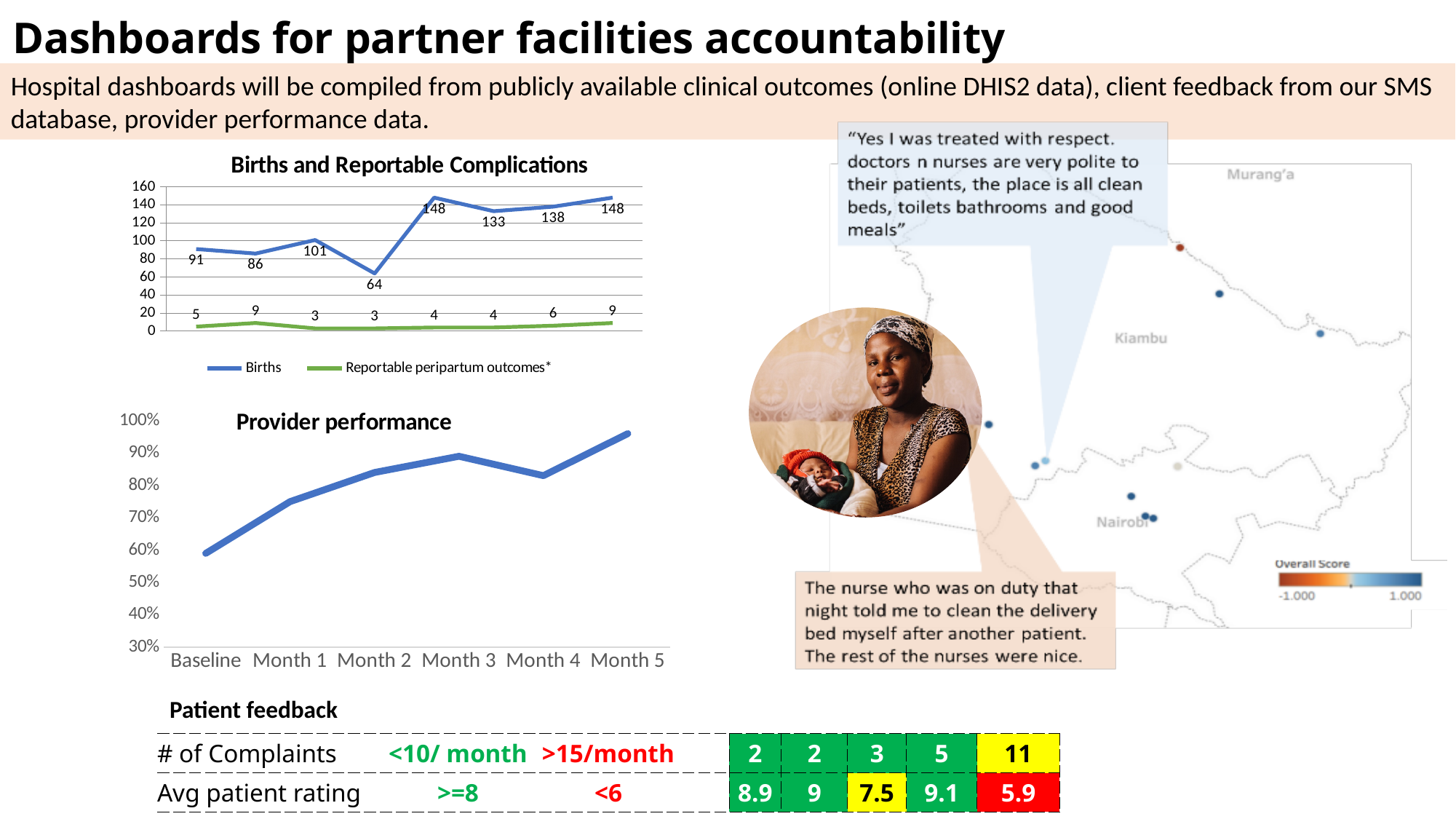
In the 'Births and Reportable Complications' chart, what is the lowest value of the Births series? 64 In the 'Births and Reportable Complications' chart, how many data points does each series have? 8 In the 'Births and Reportable Complications' chart, what is the highest value of the Births series? 148 In the 'Births and Reportable Complications' chart, what is the value of Reportable peripartum outcomes at the second point? 9 In the 'Provider performance' chart, how many categories are shown on the x axis? 6 In the 'Births and Reportable Complications' chart, what is the difference between the Births values at the third point (101) and the fourth point (64)? 37 In the 'Provider performance' chart, which is higher, Month 3 or Month 4? Month 3 What type of chart is 'Births and Reportable Complications'? Line chart In the 'Births and Reportable Complications' chart, what is the value of Births at the fourth point? 64 How many series does the legend of the 'Births and Reportable Complications' chart list? 2 In the 'Provider performance' chart, is the value for Month 5 greater or less than 90%? greater In the 'Provider performance' chart, is the value for Month 1 greater or less than 70%? greater